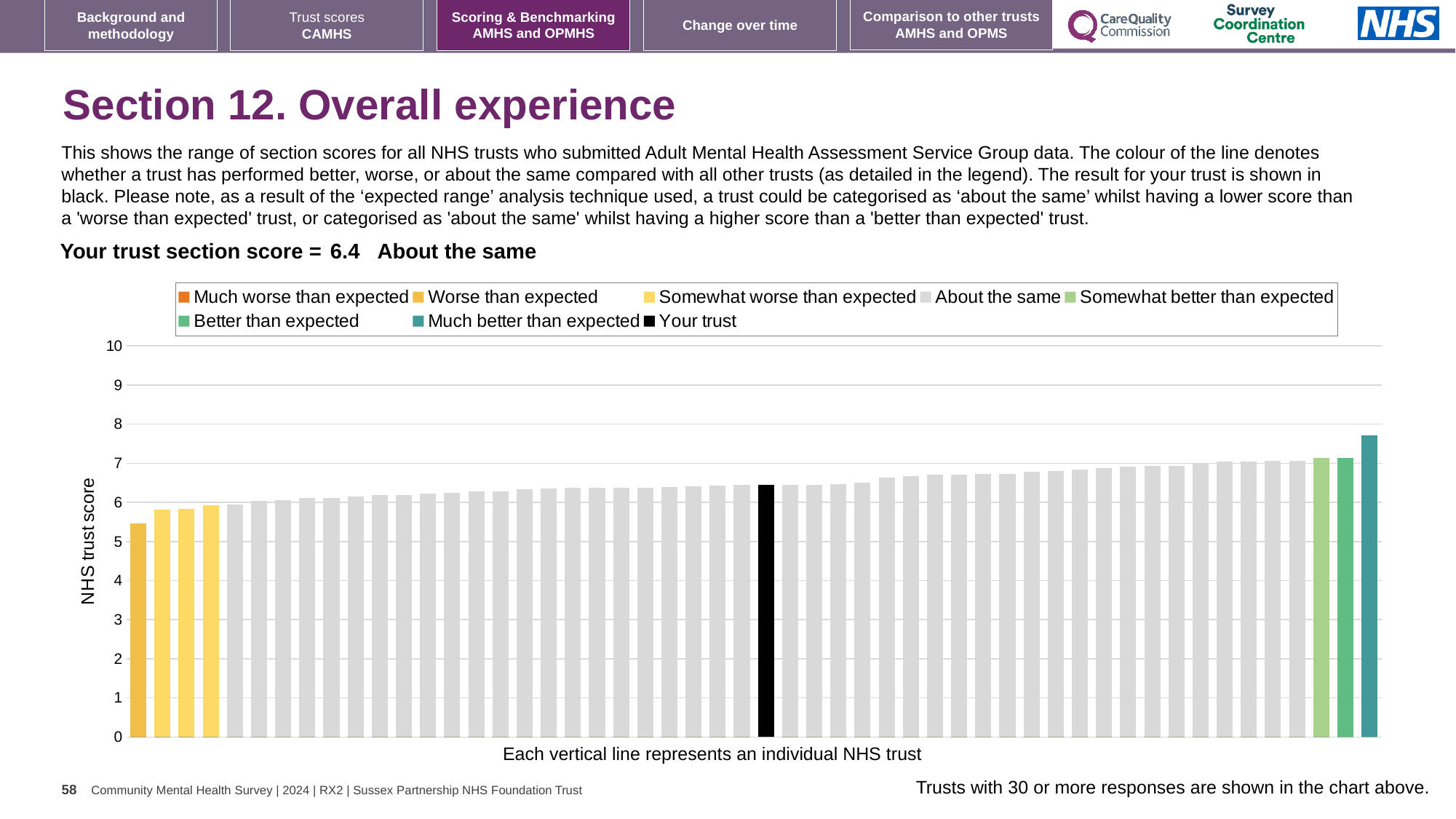
Which category is your trust placed in, according to the slide? About the same What is the label on the vertical axis of the chart? NHS trust score What is the section score for your trust, as stated on the slide? 6.4 Is the value of the shortest bar (the leftmost bar) greater or less than 6? less Is the value of the tallest bar (the rightmost, teal bar) greater or less than 7? greater What colour is the bar representing your trust? black Which is larger, the value of the leftmost bar or the value of the rightmost bar? the rightmost bar Is the value of the black 'Your trust' bar greater or less than 5? greater What kind of chart is shown on the slide? bar chart How many bars are shown in the 'Much better than expected' colour? 1 Do the bar values rise or fall from left to right along the x axis? rise How many entries does the chart legend list? 8